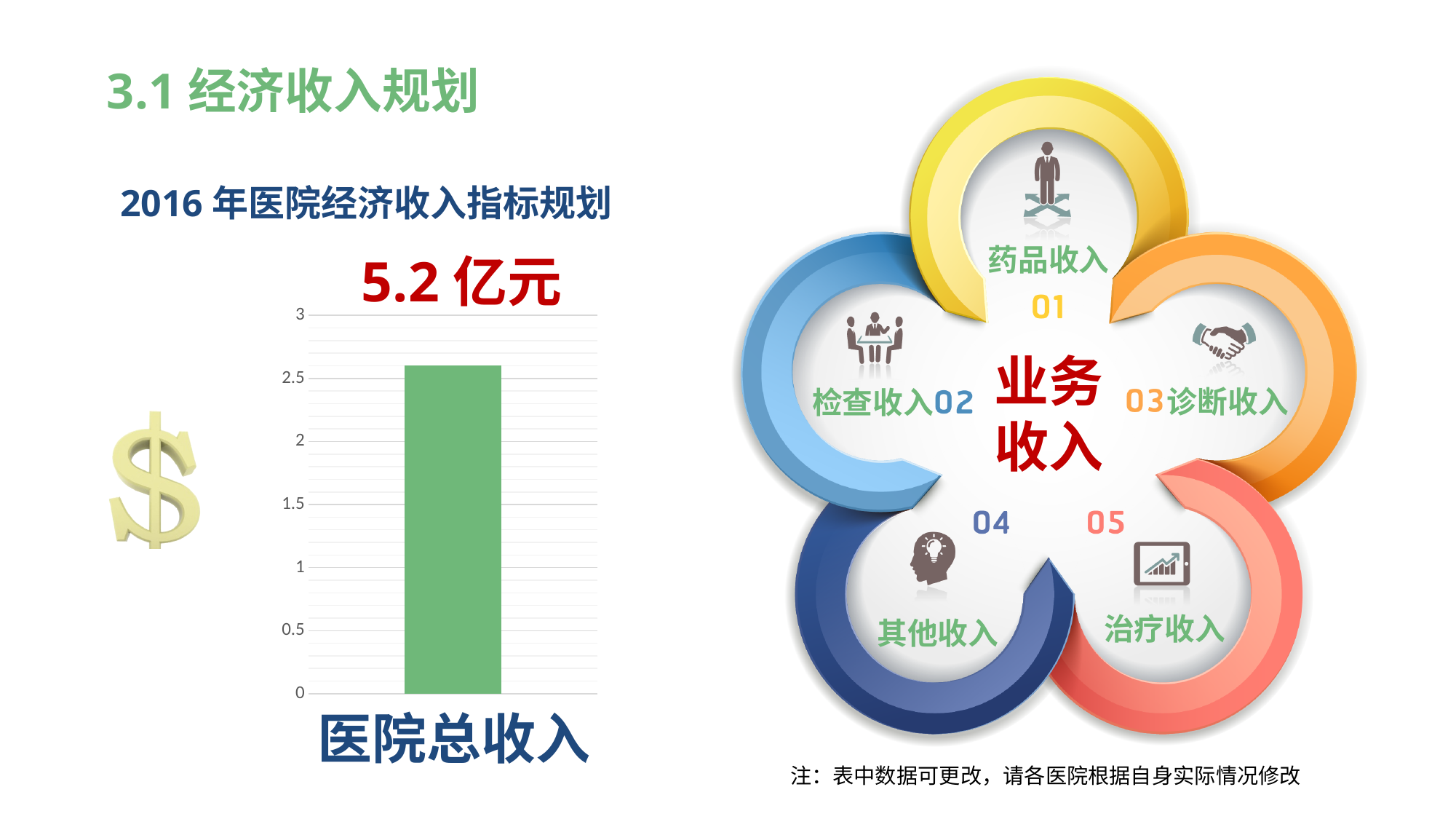
What kind of chart is shown on the left of the slide? bar chart What is the title printed above the bar chart? 2016 年医院经济收入指标规划 Is the value of the 医院总收入 bar greater or less than 1.5? greater What is the highest tick value shown on the vertical axis of the bar chart? 3 Is the value of the 医院总收入 bar greater or less than 3? less Is the value of the 医院总收入 bar greater or less than 2? greater How many bars does the bar chart on the left show? 1 What is the category label under the bar in the bar chart? 医院总收入